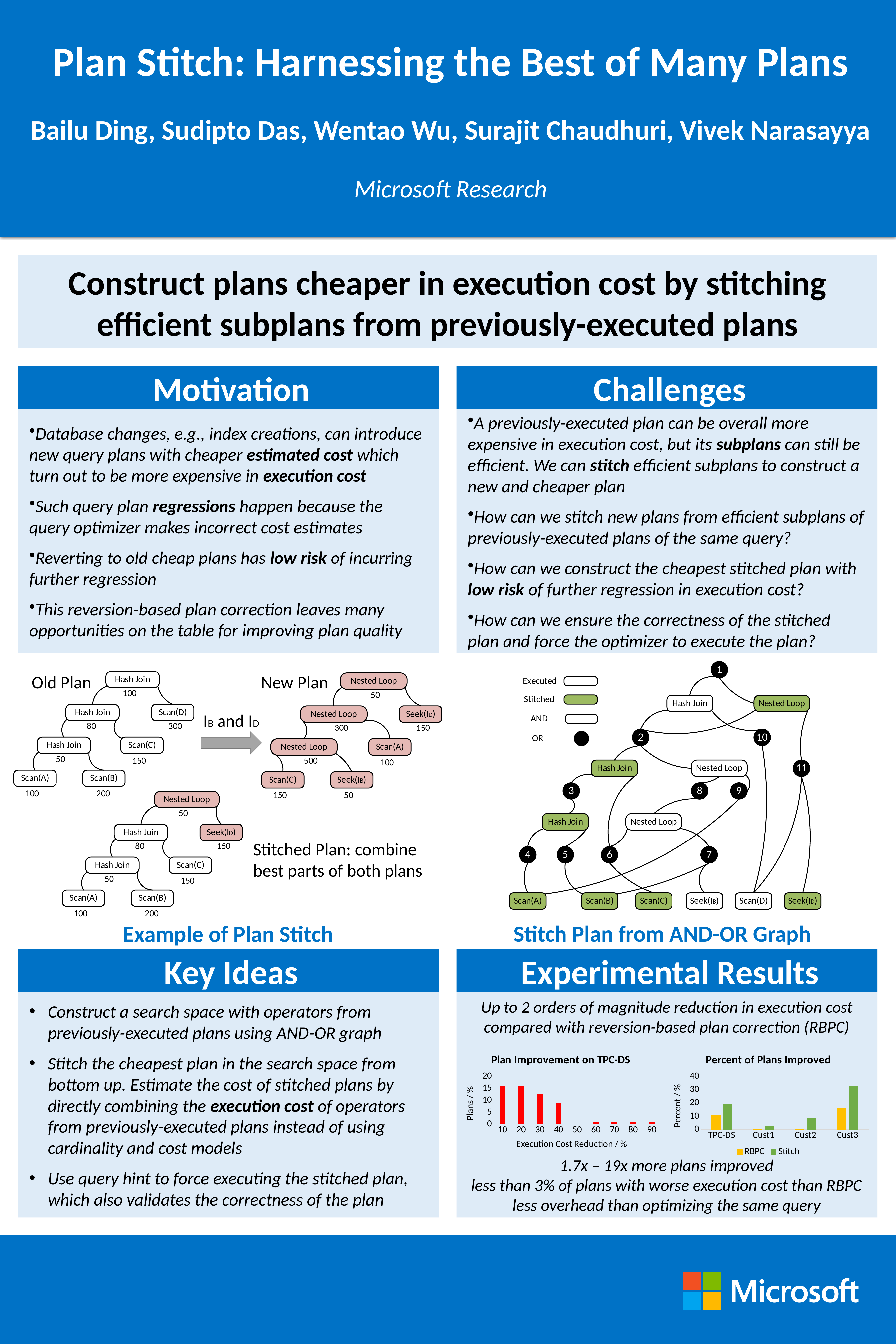
In the 'Percent of Plans Improved' chart, which category has the highest Stitch value? Cust3 How many series does the legend of the 'Percent of Plans Improved' chart list? 2 In the 'Percent of Plans Improved' chart, which colour represents the RBPC series? yellow In the 'Plan Improvement on TPC-DS' chart, do the values generally rise or fall as execution cost reduction increases along the x axis? fall In the 'Plan Improvement on TPC-DS' chart, is the value for 10% execution cost reduction greater or less than 15? greater In the 'Plan Improvement on TPC-DS' chart, is the value for 50% execution cost reduction greater or less than 5? less In the 'Plan Improvement on TPC-DS' chart, how many execution cost reduction categories are shown on the x axis? 9 In the 'Percent of Plans Improved' chart, is the Stitch value for Cust2 greater or less than 10? less In the 'Percent of Plans Improved' chart, which is larger for Cust3: RBPC or Stitch? Stitch In the 'Plan Improvement on TPC-DS' chart, what is the label of the y axis? Plans / % What kind of chart is the 'Plan Improvement on TPC-DS' chart? bar chart